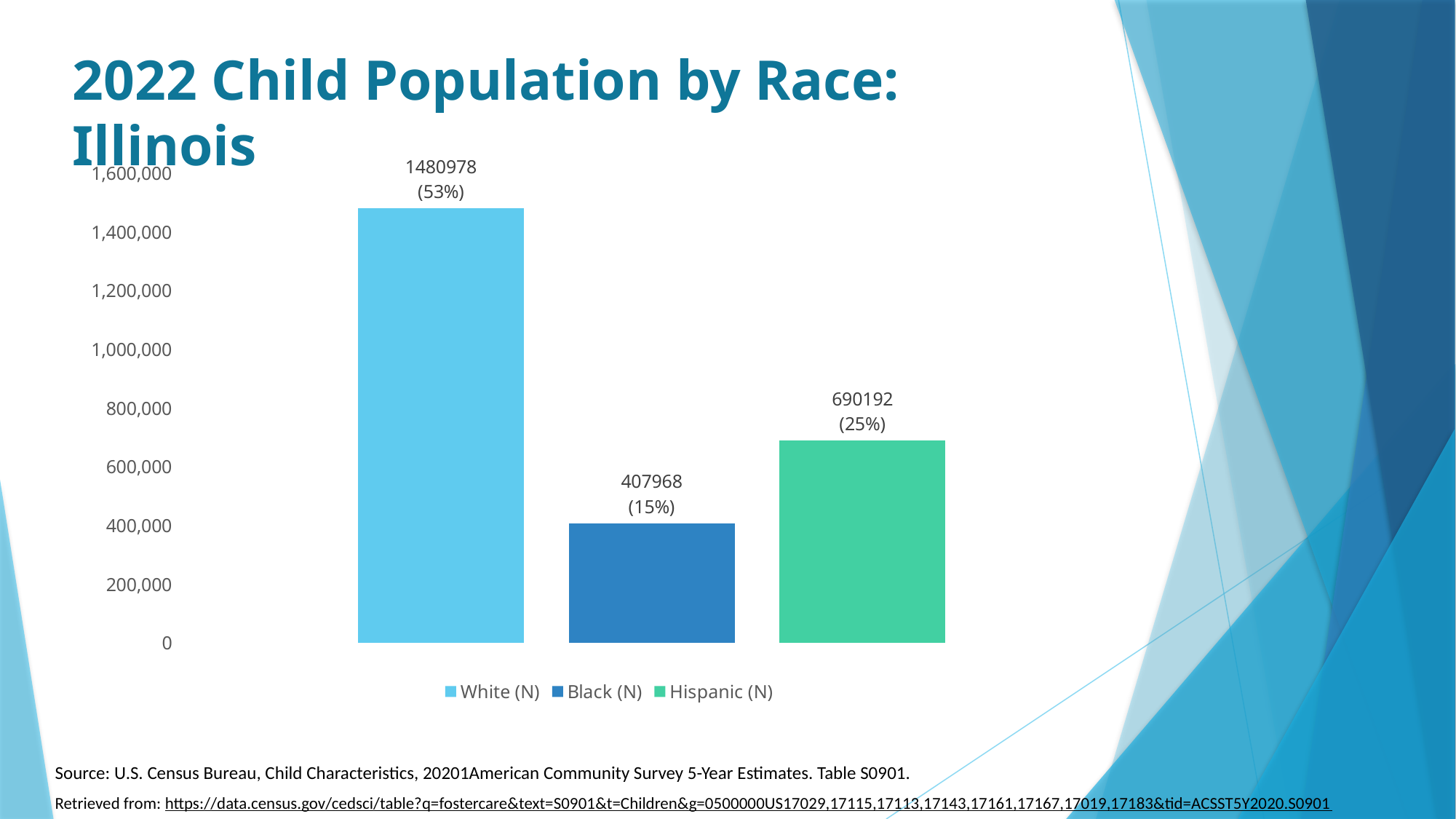
Which group has the lowest child population? Black (N) What is the difference between the values for White (N) and Hispanic (N)? 790786 What is the value shown for White (N)? 1480978 What is the value shown for Black (N)? 407968 What percentage is shown for Hispanic (N)? 25% Which group has the highest child population? White (N) What is the difference between the values for Hispanic (N) and Black (N)? 282224 What kind of chart is shown on the slide? Bar chart How many entries does the legend list? 3 Which is larger, the value for Hispanic (N) or the value for Black (N)? Hispanic (N) Is the value for White (N) greater or less than 1,400,000? greater How many bars are plotted in the chart? 3